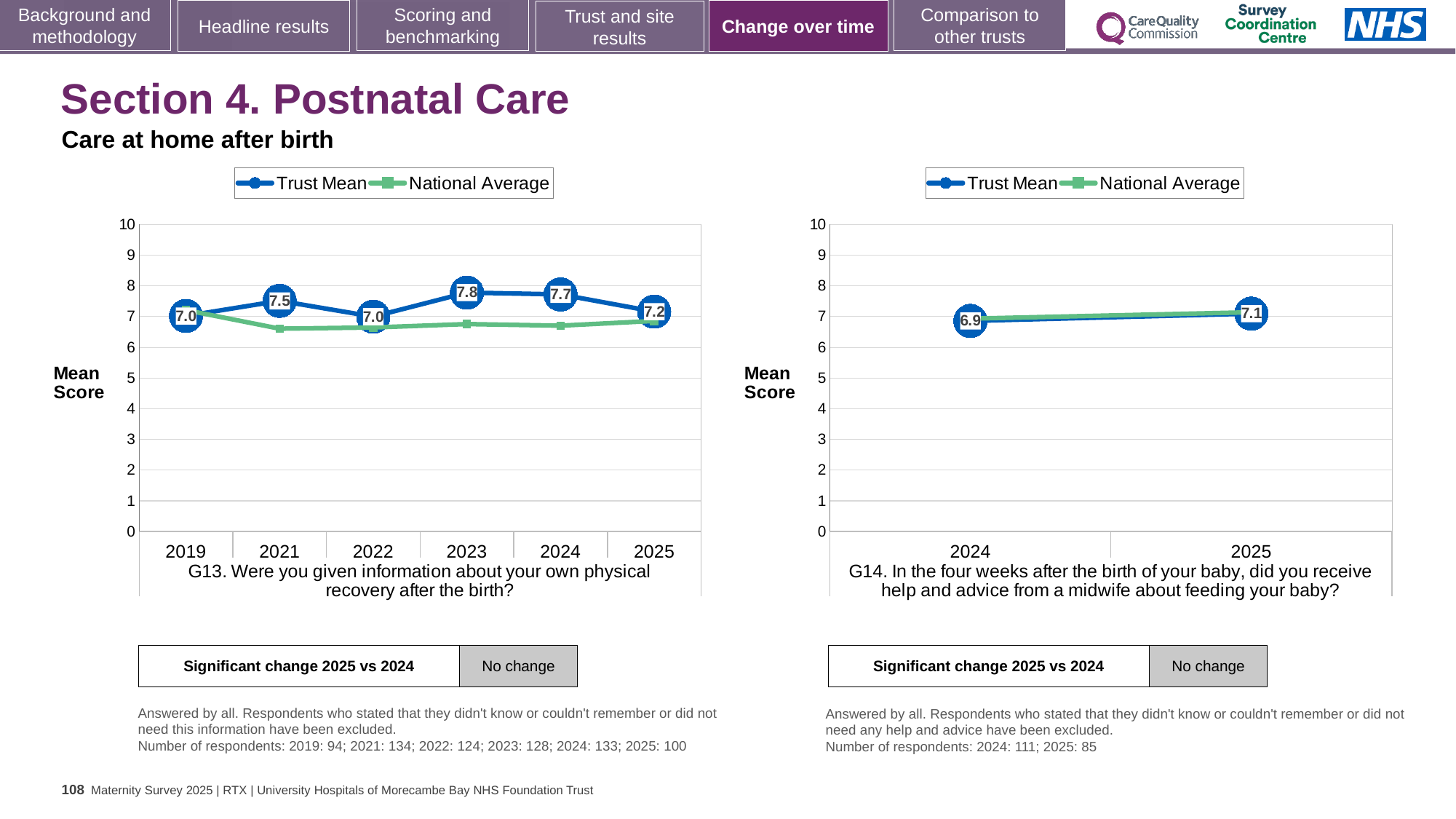
How many series does the legend of the G14 chart (right) list? 2 On the G14 chart (right), what is the Trust Mean for 2025? 7.1 On the G13 chart (left), what is the Trust Mean for 2023? 7.8 On the G13 chart (left), what is the Trust Mean for 2021? 7.5 On the G13 chart (left), is the National Average for 2021 greater or less than 7? less On the G13 chart (left), is the Trust Mean higher in 2024 or in 2025? 2024 On the G14 chart (right), does the Trust Mean rise or fall from 2024 to 2025? rise On the G14 chart (right), what is the Trust Mean for 2024? 6.9 On the G13 chart (left), which year has the highest Trust Mean? 2023 What type of chart is the G13 chart (left)? line chart On the G13 chart (left), how many years are shown on the x axis? 6 On the G13 chart (left), what is the difference between the Trust Mean in 2023 and in 2025? 0.6